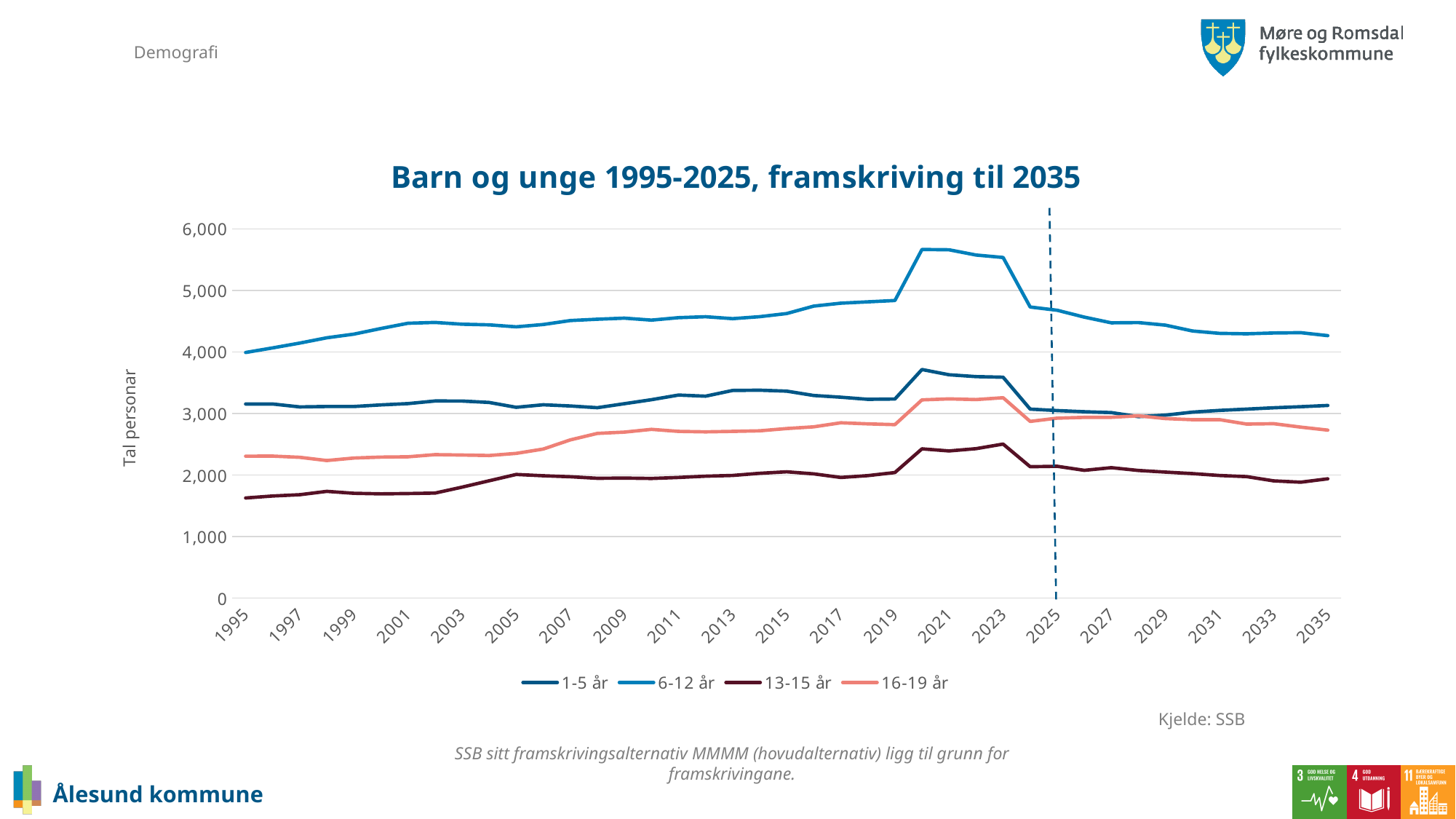
Is the value for 6-12 år in 2021 greater or less than 5,000? greater What is the title of the chart? Barn og unge 1995-2025, framskriving til 2035 Is the value for 16-19 år in 2035 greater or less than 3,000? less Which series has the highest values across the whole chart? 6-12 år Which series has the lowest values across the whole chart? 13-15 år What is the label on the vertical axis? Tal personar Is the value for 13-15 år in 1995 greater or less than 2,000? less What kind of chart is shown on the slide? line chart In 2021, which is larger: the value for 1-5 år or the value for 16-19 år? 1-5 år How many series does the legend list? 4 Does the 6-12 år series rise or fall from 2023 to 2035? fall